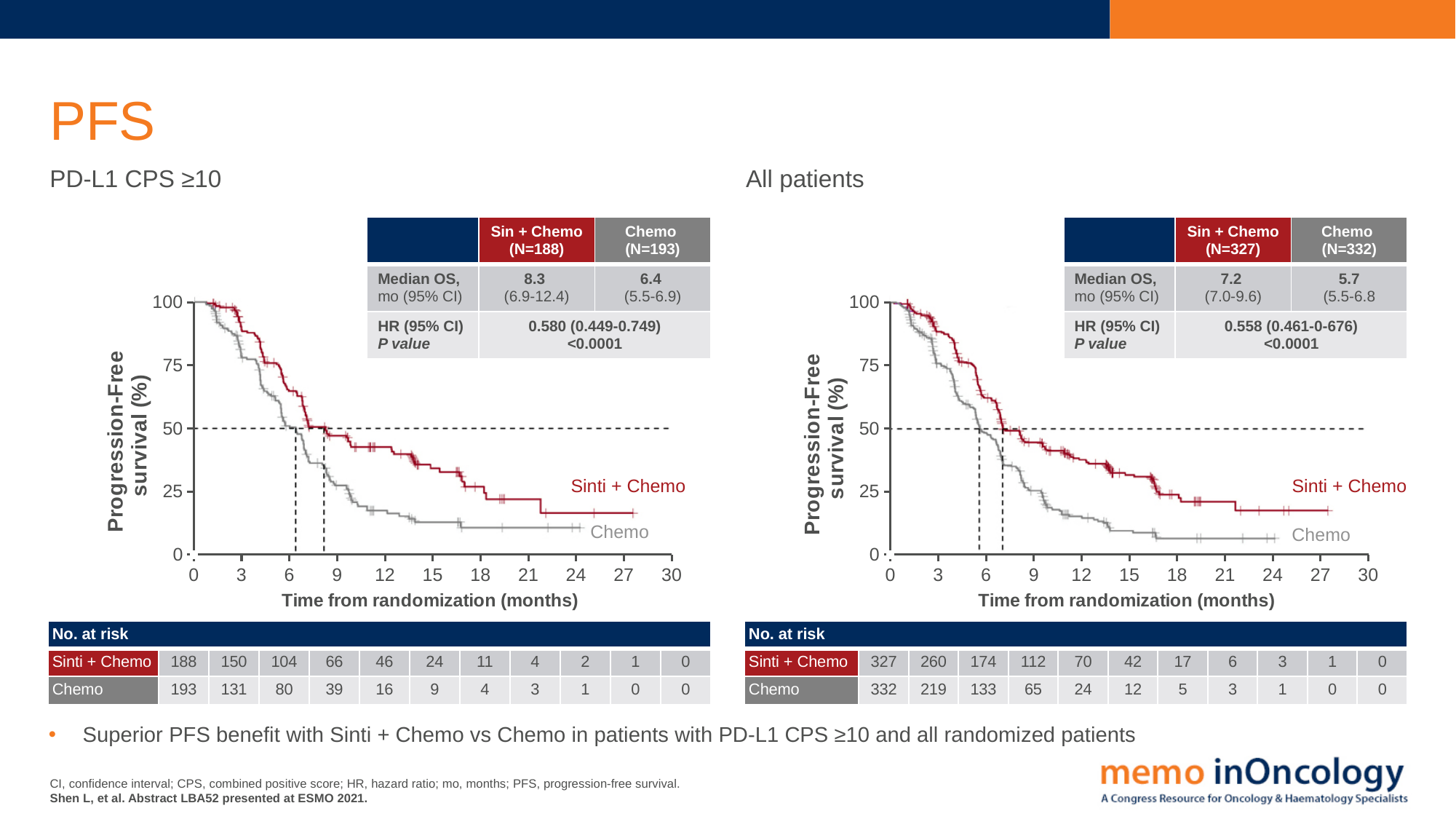
In the All patients chart on the right, what is the median PFS in months for the Sin + Chemo arm? 7.2 How many treatment arms are plotted in the All patients chart on the right? 2 In the PD-L1 CPS ≥10 chart on the left, what is the median PFS in months for the Sin + Chemo arm? 8.3 In the PD-L1 CPS ≥10 chart on the left, is the progression-free survival for Chemo at 12 months greater or less than 25%? less In the PD-L1 CPS ≥10 chart on the left, what is the difference in median PFS (months) between Sin + Chemo and Chemo? 1.9 In the PD-L1 CPS ≥10 chart on the left, do the survival curves rise or fall as time from randomization increases? fall In the PD-L1 CPS ≥10 chart on the left, how many Sinti + Chemo patients were at risk at 12 months? 46 In the All patients chart on the right, which arm has the higher progression-free survival at 12 months? Sinti + Chemo In the All patients chart on the right, how many Chemo patients were at risk at 6 months? 133 What kind of chart is used on this slide to show progression-free survival? line chart In the PD-L1 CPS ≥10 chart on the left, what is the median PFS in months for the Chemo arm? 6.4 In the All patients chart on the right, what is the hazard ratio with its 95% CI? 0.558 (0.461-0.676)